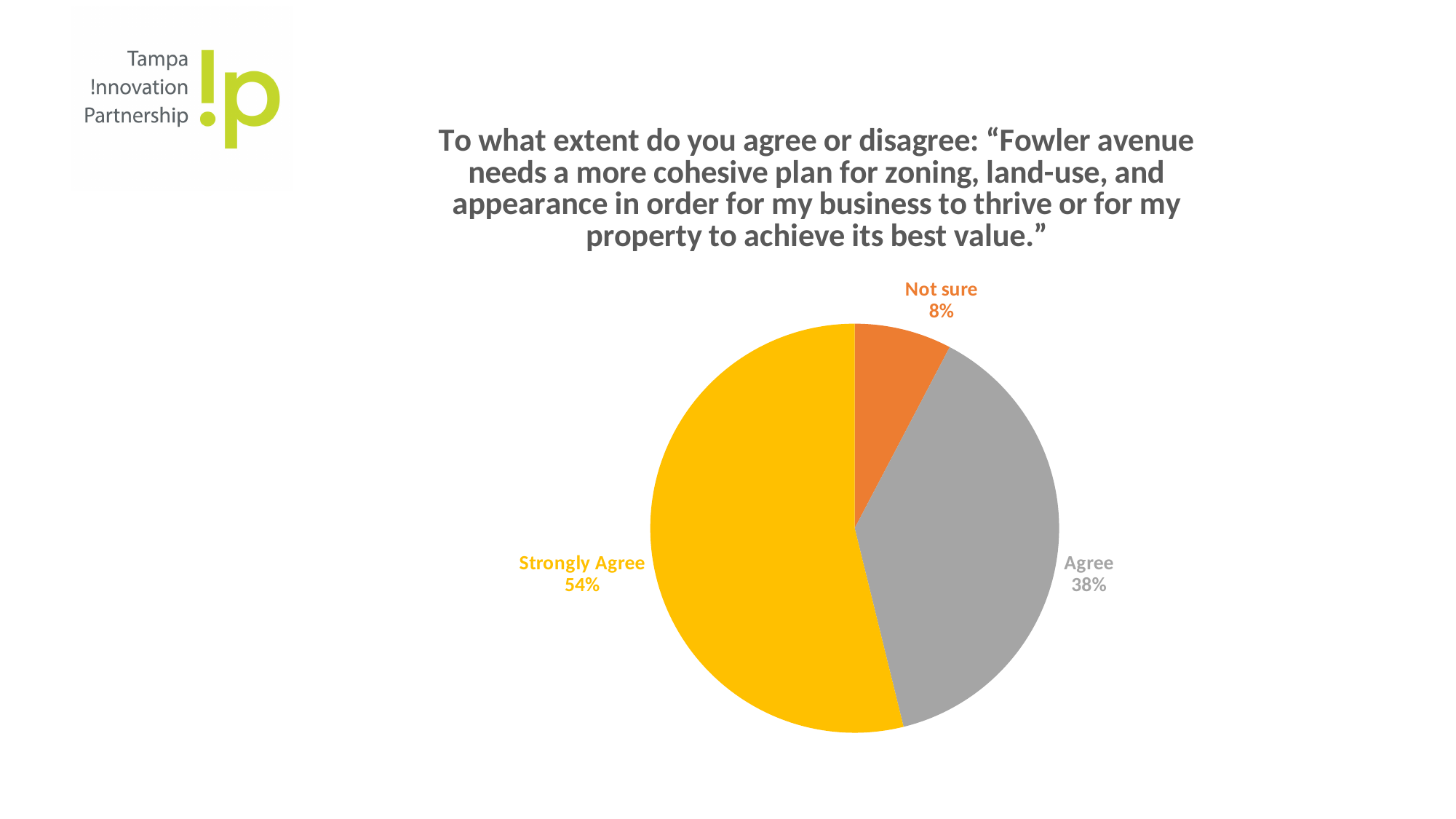
What is the combined share of "Strongly Agree" and "Agree"? 92% What is the difference in percentage points between "Agree" and "Not sure"? 30 What percentage of respondents answered "Strongly Agree"? 54% Which is larger, the share for "Agree" or the share for "Not sure"? Agree What kind of chart is shown on the slide? Pie chart Which response has the smallest share of the pie? Not sure Which response has the largest share of the pie? Strongly Agree What is the difference in percentage points between "Strongly Agree" and "Agree"? 16 How many slices does the pie chart have? 3 What colour is the "Not sure" slice? Orange What percentage of respondents answered "Not sure"? 8% What percentage of respondents answered "Agree"? 38%